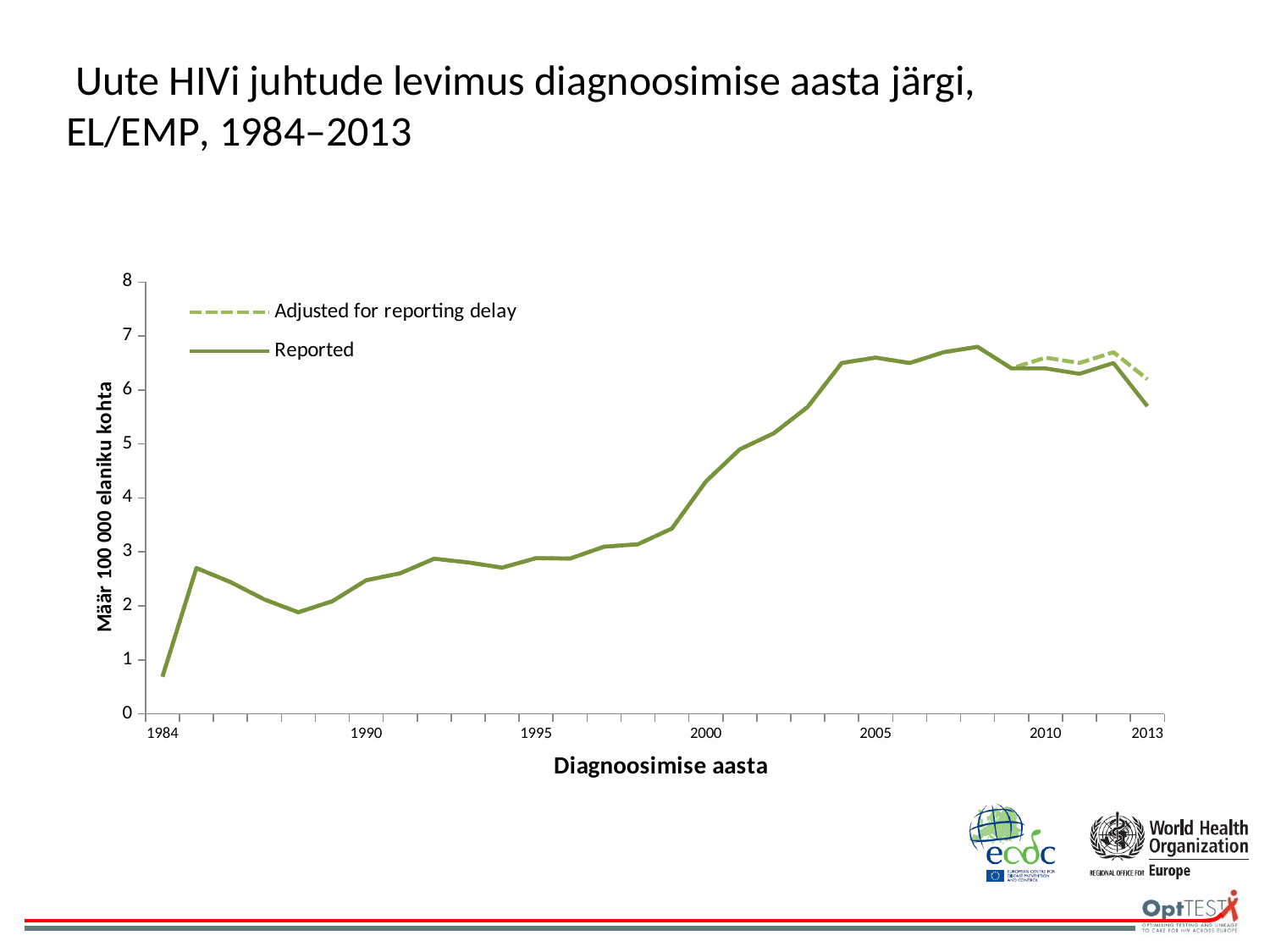
What kind of chart is shown on the slide? line chart In which year is the Reported value lowest? 1984 Overall, do the Reported values rise or fall from 1984 to 2008? rise Is the Reported value for 2005 greater or less than 6? greater What are the two series named in the legend? Adjusted for reporting delay; Reported Is the Reported value for 1990 greater or less than 2? greater How many series does the legend list? 2 What is the title of the x axis? Diagnoosimise aasta Is the Reported value for 1984 greater or less than 1? less Which is larger, the Reported value for 1995 or for 2005? 2005